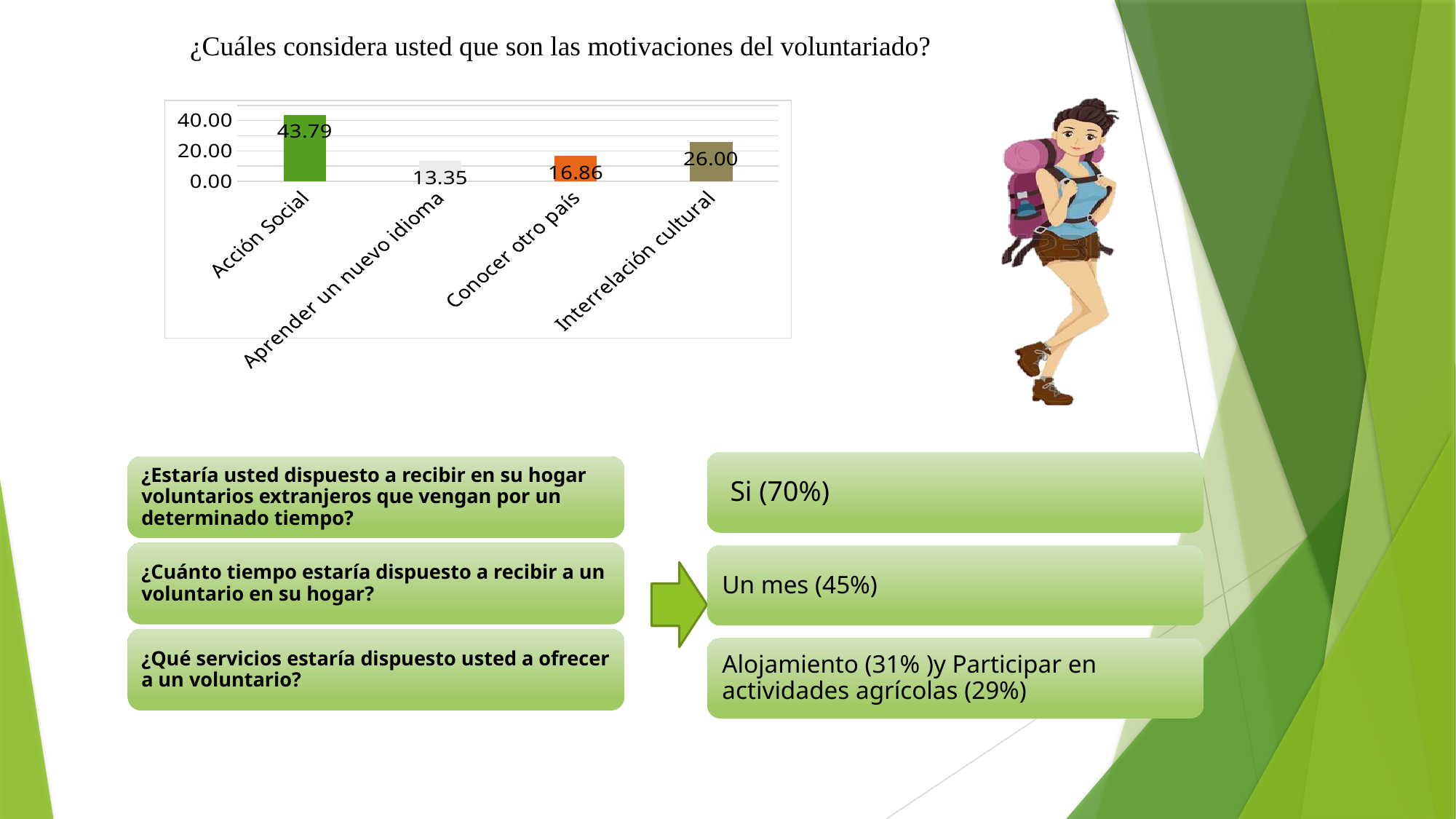
Which is larger, the value for Conocer otro país or the value for Interrelación cultural? Interrelación cultural What is the difference between the values for Acción Social and Interrelación cultural? 17.79 Which category has the highest value? Acción Social What is the value for Interrelación cultural? 26.00 What is the value for Aprender un nuevo idioma? 13.35 What is the value for Conocer otro país? 16.86 What is the value for Acción Social? 43.79 Which category has the lowest value? Aprender un nuevo idioma What colour is the bar for Conocer otro país? orange How many categories are shown in the chart? 4 What kind of chart is shown on the slide? bar chart Is the value for Acción Social greater or less than 40.00? greater